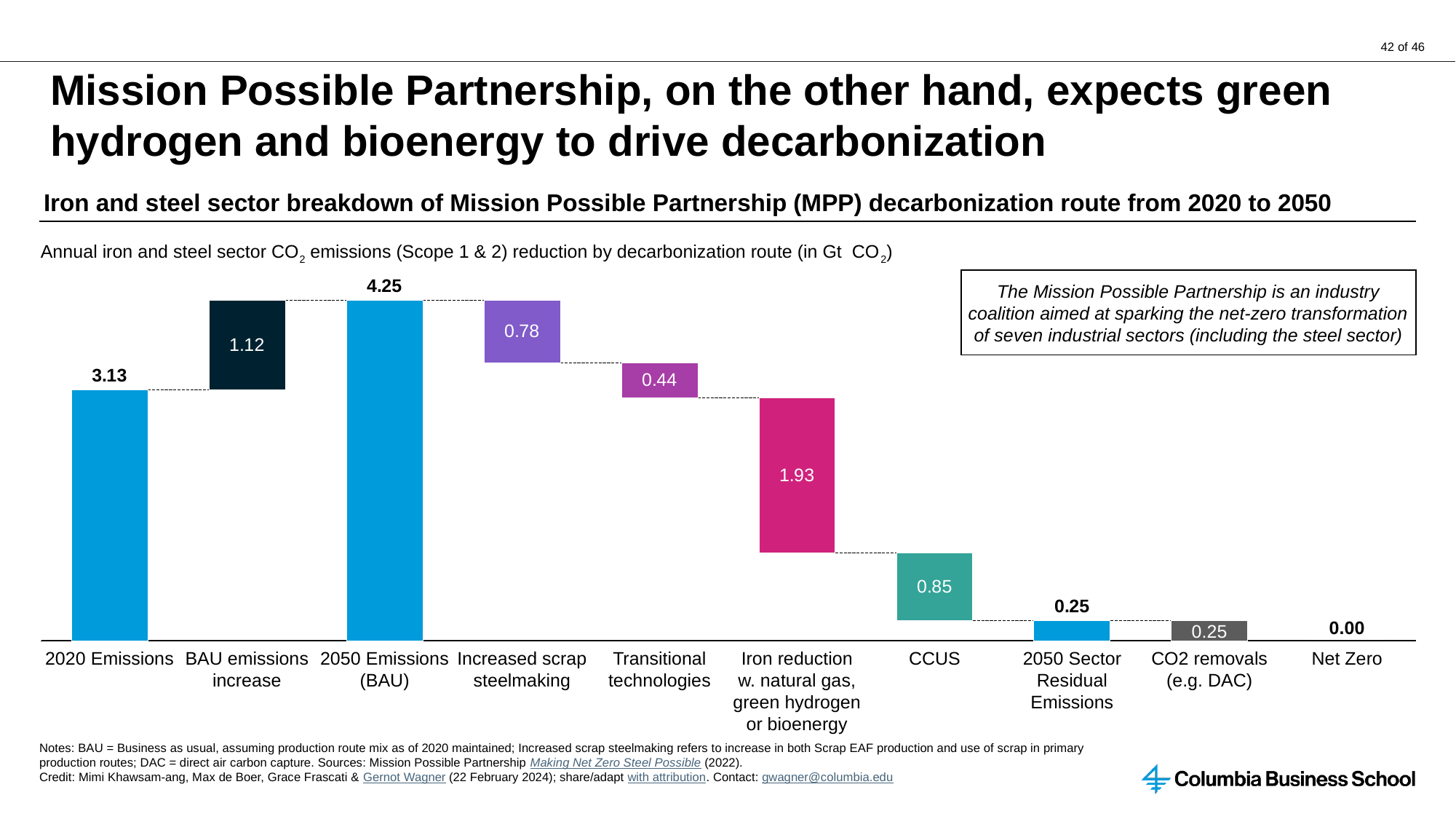
What is the difference between 2050 Emissions (BAU) and 2020 Emissions? 1.12 What is the difference between the reduction from Increased scrap steelmaking and the reduction from Transitional technologies? 0.34 What is the value shown for CCUS? 0.85 What is the value shown for 2020 Emissions? 3.13 What kind of chart is shown on the slide? Waterfall bar chart Which decarbonization route contributes the largest emissions reduction? Iron reduction w. natural gas, green hydrogen or bioenergy What is the value shown for 2050 Emissions (BAU)? 4.25 Which category has the highest value in the chart? 2050 Emissions (BAU) Which is larger, the reduction from CCUS or the reduction from Transitional technologies? CCUS How many categories are shown along the x axis of the chart? 10 What is the value shown for 2050 Sector Residual Emissions? 0.25 What reduction is attributed to Iron reduction w. natural gas, green hydrogen or bioenergy? 1.93